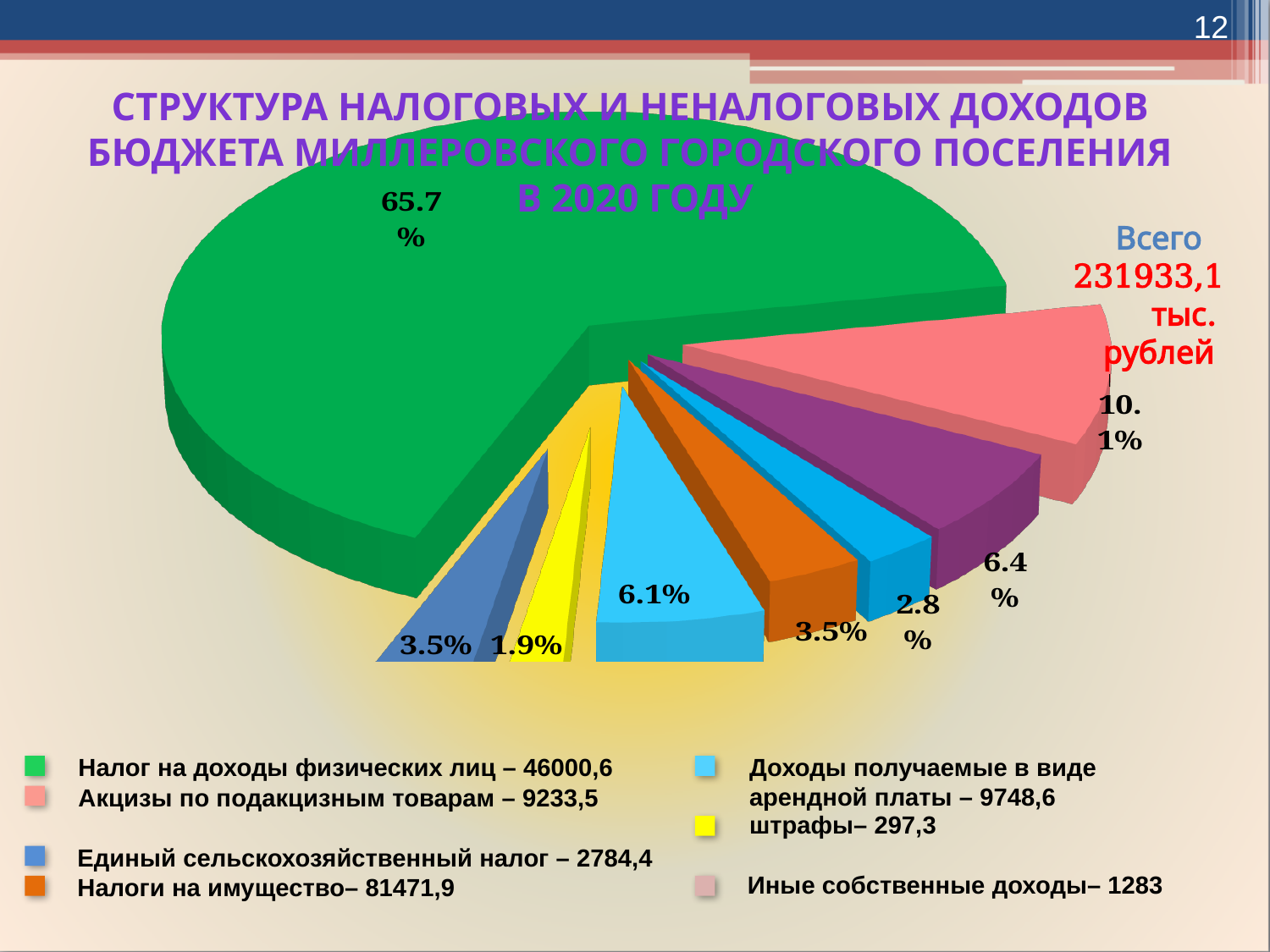
What is the difference in percentage points between the 65.7% slice and the 10.1% slice? 55.6 What percentage is shown for the smallest slice of the pie chart? 1.9% What value is given in the legend for 'Налог на доходы физических лиц'? 46000,6 What value is given in the legend for 'Иные собственные доходы'? 1283 What type of chart is shown on the slide? pie chart What percentage is shown for the largest slice of the pie chart? 65.7% How many slices does the pie chart have? 8 According to the legend, which has the larger value: 'Налоги на имущество' or 'Налог на доходы физических лиц'? Налоги на имущество What value is given in the legend for 'штрафы'? 297,3 What total amount (Всего) is shown next to the pie chart? 231933,1 тыс. рублей What colour is the largest slice of the pie chart? green What value is given in the legend for 'Акцизы по подакцизным товарам'? 9233,5